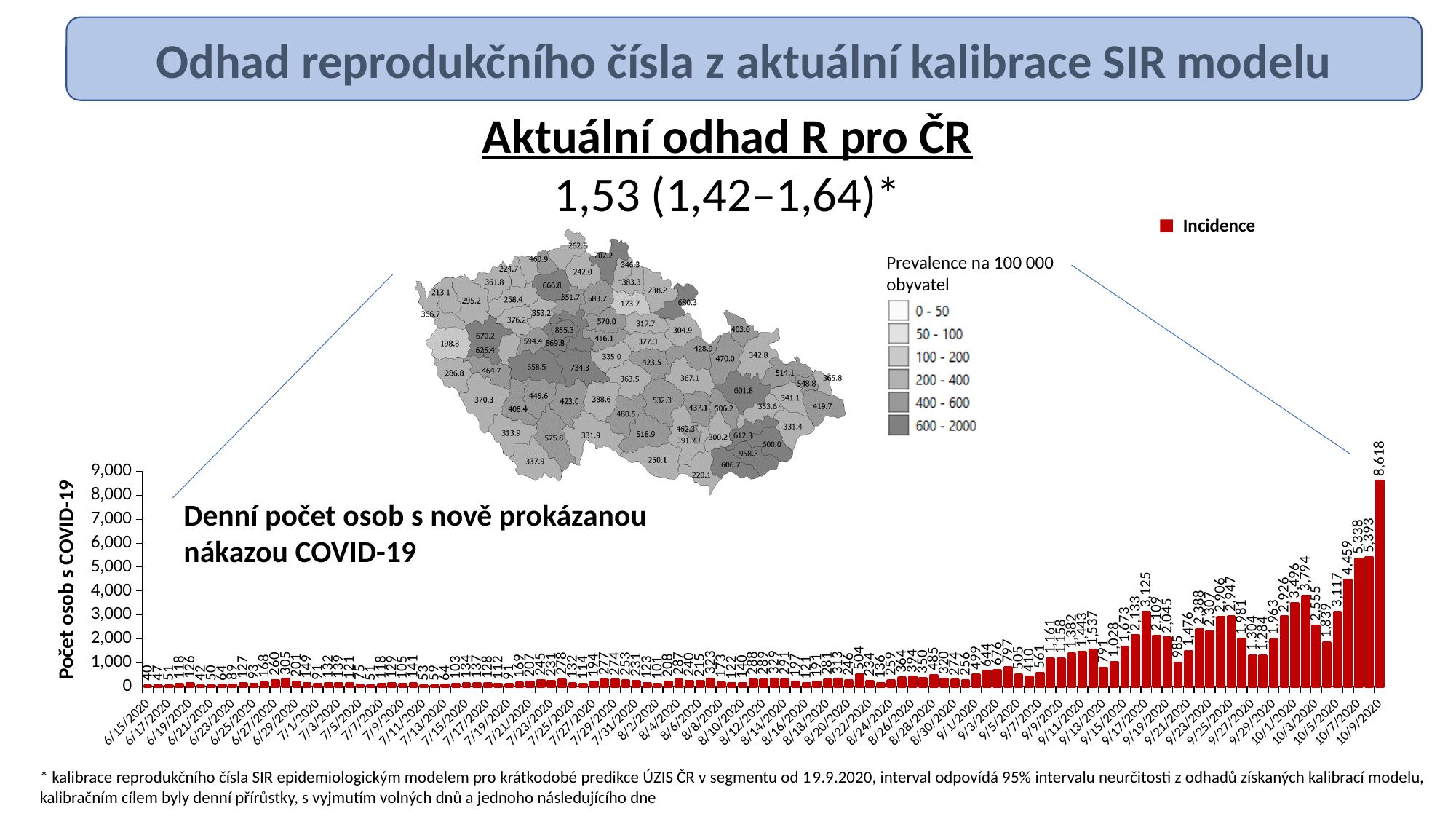
Is the daily number of newly confirmed COVID-19 cases on 10/9/2020 greater or less than 8,000? greater What is the daily number of newly confirmed COVID-19 cases on 6/15/2020, the first date on the chart? 40 How many series does the legend of the bar chart list? 1 What is the difference between the daily number of newly confirmed COVID-19 cases on 10/9/2020 and on 6/15/2020? 8,578 What is the daily number of newly confirmed COVID-19 cases on 10/9/2020? 8,618 What is the label of the vertical axis of the bar chart? Počet osob s COVID-19 On which date does the daily number of newly confirmed COVID-19 cases reach its highest value? 10/9/2020 Is the daily number of newly confirmed COVID-19 cases on 9/9/2020 greater or less than 2,000? less Overall, do the daily numbers of newly confirmed COVID-19 cases rise or fall from 6/15/2020 to 10/9/2020? rise What kind of chart is used to show the daily number of newly confirmed COVID-19 cases? bar chart What is the name of the series shown in the legend of the bar chart? Incidence Which date has more newly confirmed COVID-19 cases, 6/15/2020 or 10/9/2020? 10/9/2020